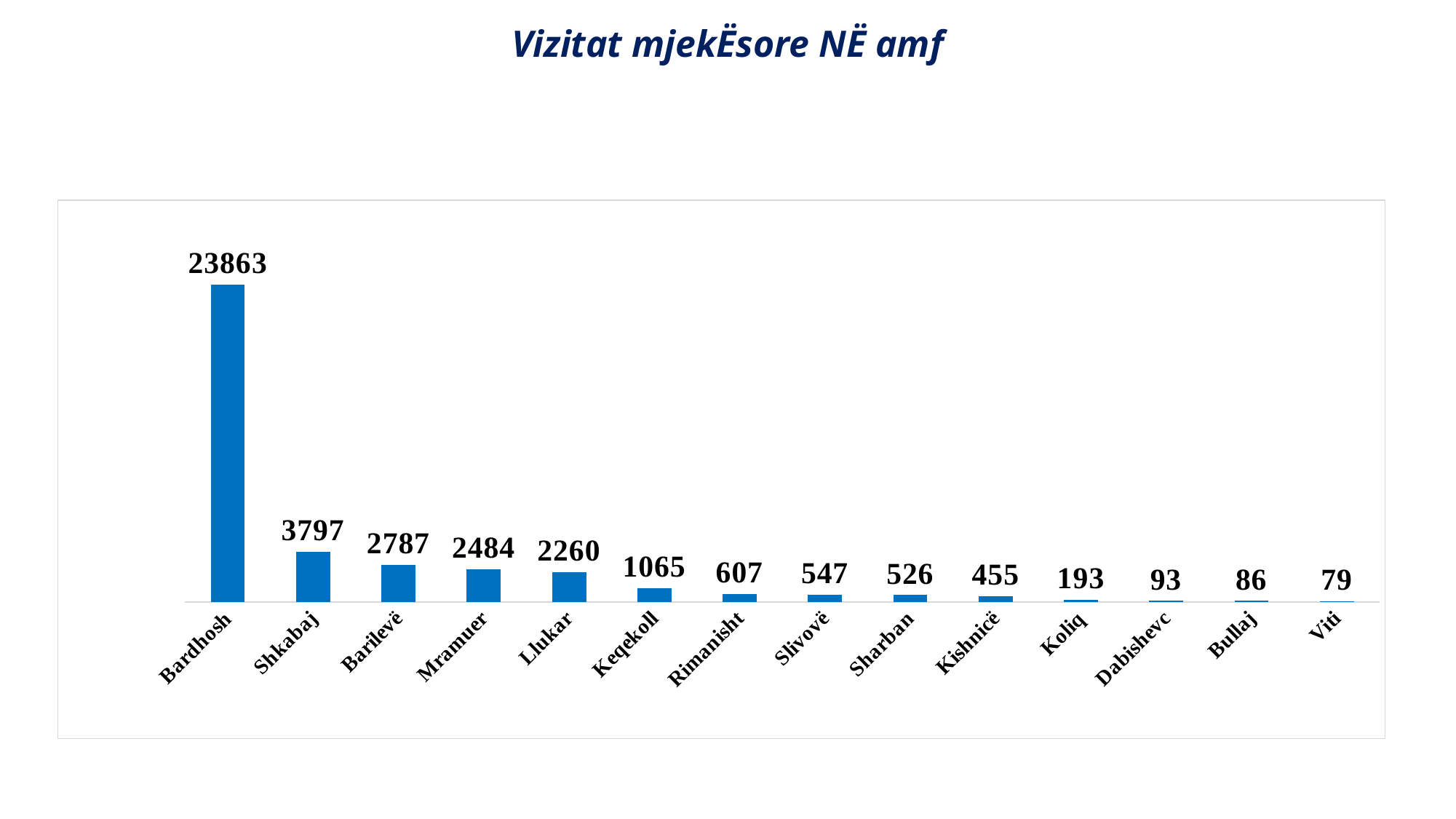
What is the value for Viti? 79 What is the value for Shkabaj? 3797 What is the value for Keqekoll? 1065 What kind of chart is shown on the slide? Bar chart How many categories are shown on the chart? 14 What is the value for Bardhosh? 23863 Which category has the lowest value? Viti What is the difference between the values for Bardhosh and Shkabaj? 20066 Which has a larger value, Mramuer or Llukar? Mramuer What is the difference between the values for Shkabaj and Barilevë? 1010 What is the title of the chart? Vizitat mjekËsore NË amf Which category has the highest value? Bardhosh